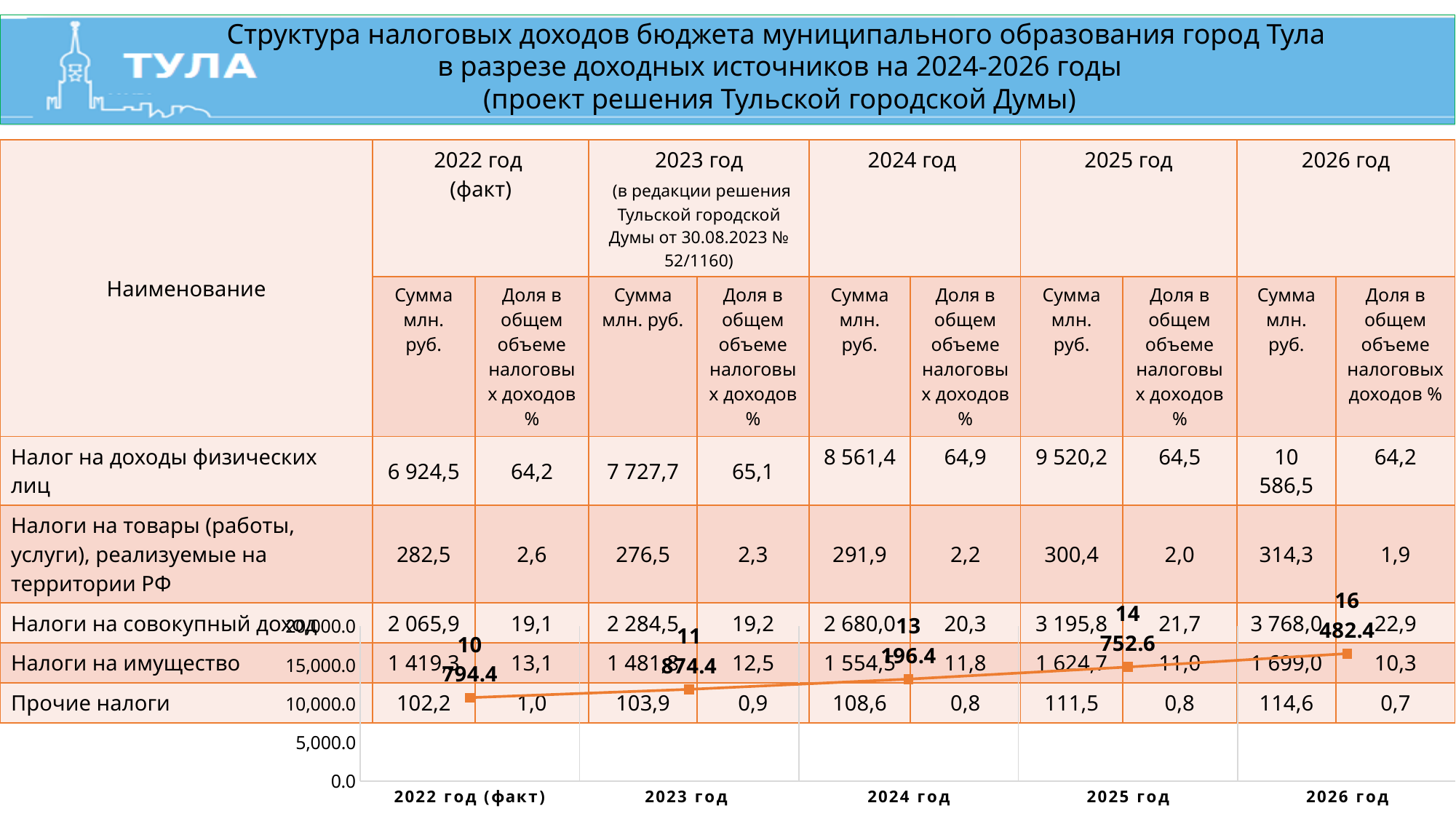
What is the value plotted for 2025 год on the line chart? 14 752.6 What is the difference between the 2026 год value and the 2022 год (факт) value on the line chart? 5 688.0 Do the values on the line chart rise or fall from 2022 to 2026? rise What kind of chart is overlaid on the table on the slide? line chart What is the value plotted for 2023 год on the line chart? 11 874.4 What is the value plotted for 2022 год (факт) on the line chart? 10 794.4 Which year has the highest value on the line chart? 2026 год Which year has the lowest value on the line chart? 2022 год (факт) How many data points are plotted on the line chart? 5 What is the value plotted for 2026 год on the line chart? 16 482.4 What is the value plotted for 2024 год on the line chart? 13 196.4 Is the value for 2024 год on the line chart greater or less than 15,000.0? less